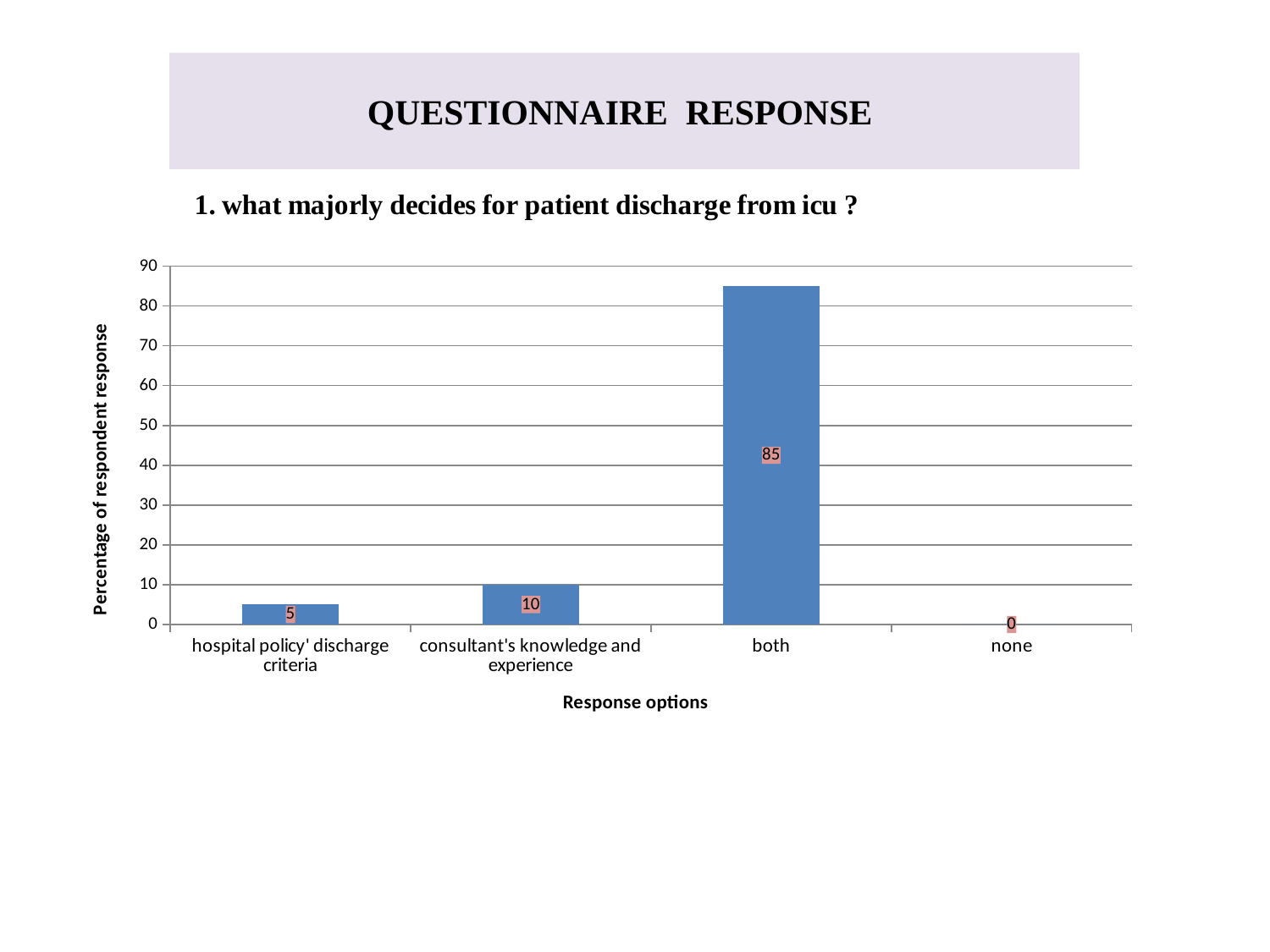
What is the value for "none"? 0 Is the value for "both" greater or less than 80? greater What is the value for "consultant's knowledge and experience"? 10 How many response options are shown on the x axis? 4 Which response option has the lowest value? none What is the value for "both"? 85 What is the label of the y axis? Percentage of respondent response Which response option has the highest value? both What kind of chart is shown on the slide? bar chart Which is larger, the value for "consultant's knowledge and experience" or the value for "hospital policy' discharge criteria"? consultant's knowledge and experience What is the value for "hospital policy' discharge criteria"? 5 What is the difference between the values for "both" and "consultant's knowledge and experience"? 75